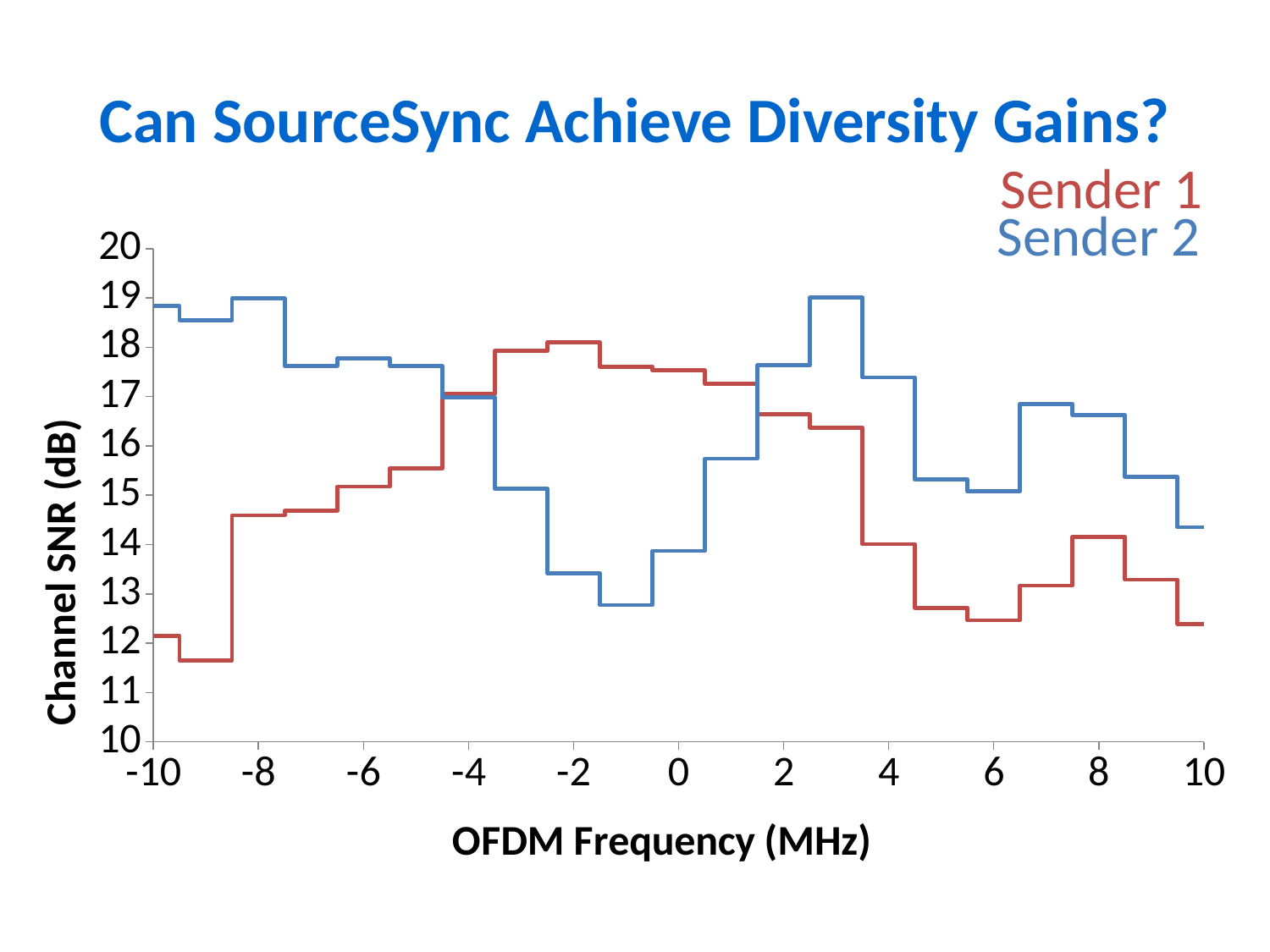
What kind of chart is shown on the slide? line chart Is the Sender 2 value at -1 MHz greater or less than 13? less How many series does the legend list? 2 At -8 MHz, which sender has the higher channel SNR? Sender 2 What is the label of the y axis? Channel SNR (dB) Does the Sender 1 channel SNR rise or fall as frequency goes from -10 MHz to -2 MHz? rise Is the Sender 2 value at -10 MHz greater or less than 18? greater Which sender reaches the highest channel SNR anywhere on the chart? Sender 2 What is the title of the chart on the slide? Can SourceSync Achieve Diversity Gains? Is the Sender 1 value at -9 MHz greater or less than 12? less At -2 MHz, which sender has the higher channel SNR? Sender 1